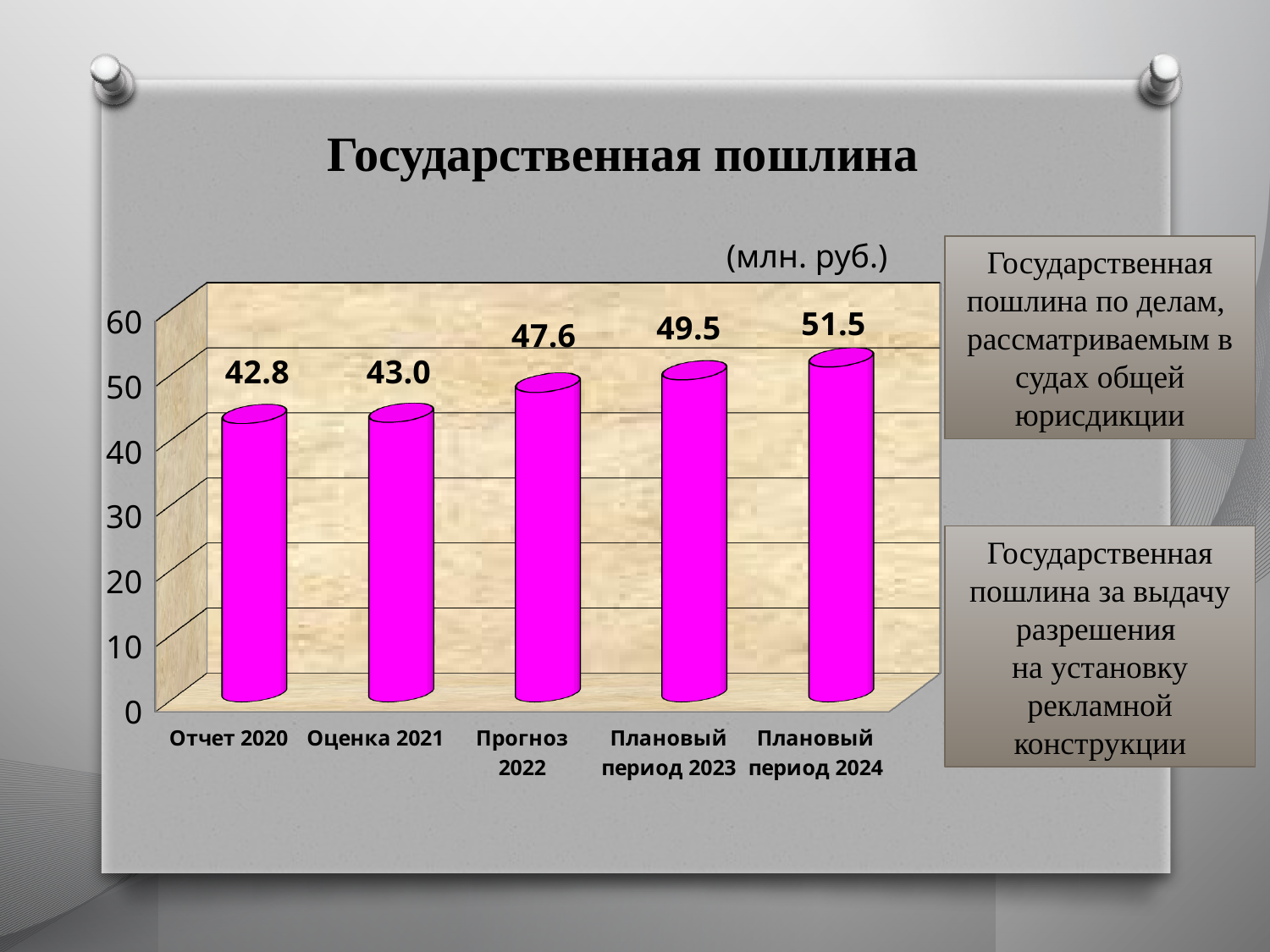
Which category has the lowest value? Отчет 2020 What is the value for Прогноз 2022? 47.6 What kind of chart is shown on the slide? bar chart Do the values rise or fall from Отчет 2020 to Плановый период 2024? rise Is the value for Плановый период 2023 greater or less than 40? greater What is the value for Плановый период 2024? 51.5 What is the difference between the values for Плановый период 2023 and Прогноз 2022? 1.9 How many categories are shown on the x axis? 5 Which category has the highest value? Плановый период 2024 Which is larger, the value for Прогноз 2022 or the value for Оценка 2021? Прогноз 2022 What is the value for Отчет 2020? 42.8 What is the difference between the values for Плановый период 2024 and Отчет 2020? 8.7